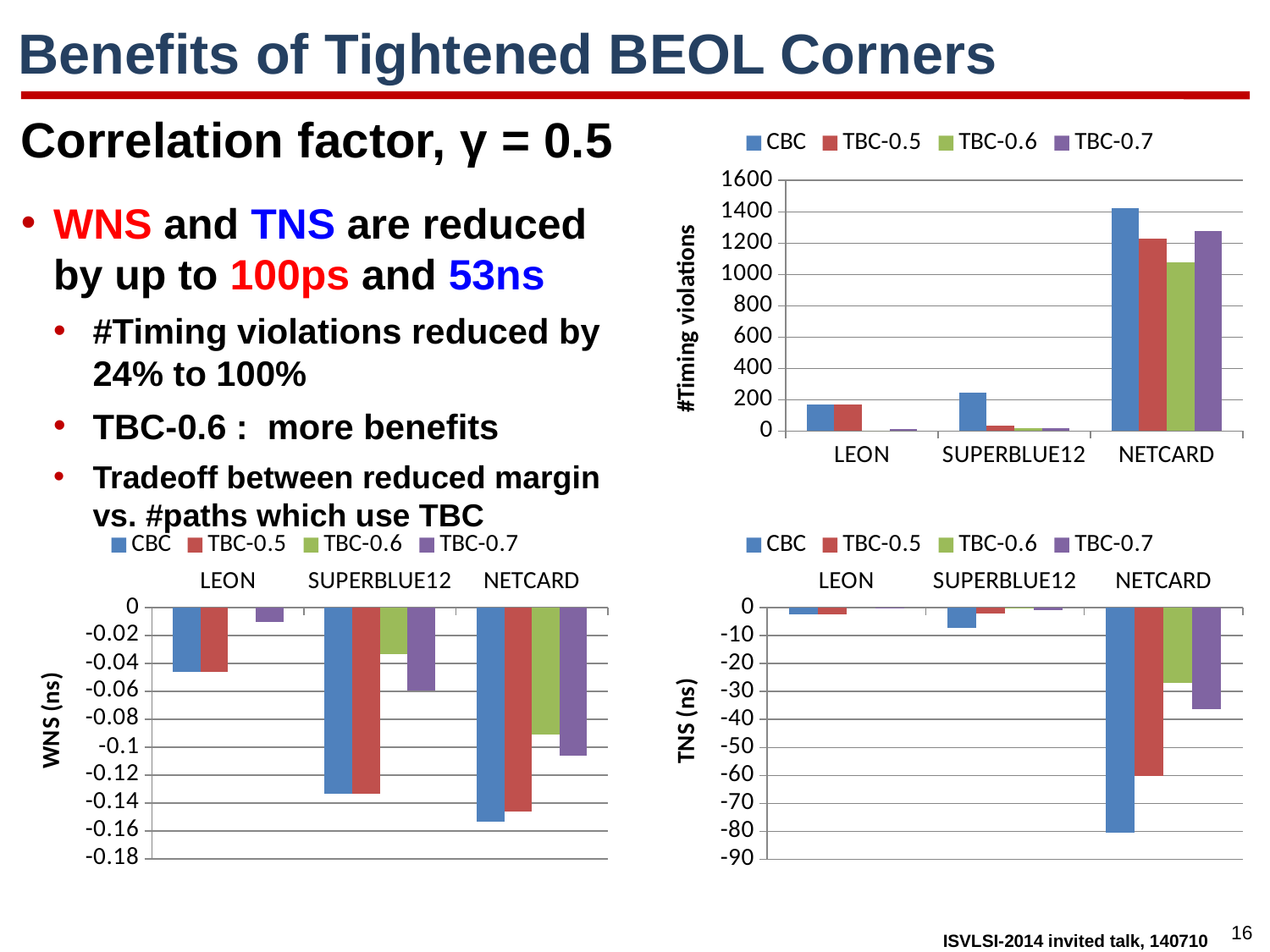
In the top-right #Timing violations chart, is the TBC-0.6 value for NETCARD greater or less than 1200? less How many categories are shown on the x axis of the bottom-left WNS (ns) chart? 3 In the bottom-right TNS (ns) chart, is the CBC value for NETCARD greater or less than -70? less In the top-right #Timing violations chart, is the CBC value for NETCARD greater or less than 1200? greater In the bottom-left WNS (ns) chart, which series has the lowest (most negative) value for NETCARD? CBC What are the four legend entries of the bottom-right TNS (ns) chart? CBC, TBC-0.5, TBC-0.6, TBC-0.7 What kind of chart is the top-right chart with the y axis labelled #Timing violations? bar chart In the bottom-right TNS (ns) chart, which series has the highest (least negative) value for NETCARD? TBC-0.6 In the top-right #Timing violations chart, which is larger for NETCARD: the TBC-0.6 value or the TBC-0.7 value? TBC-0.7 How many series does the legend of the top-right #Timing violations chart list? 4 In the top-right #Timing violations chart, which category has the highest CBC value? NETCARD